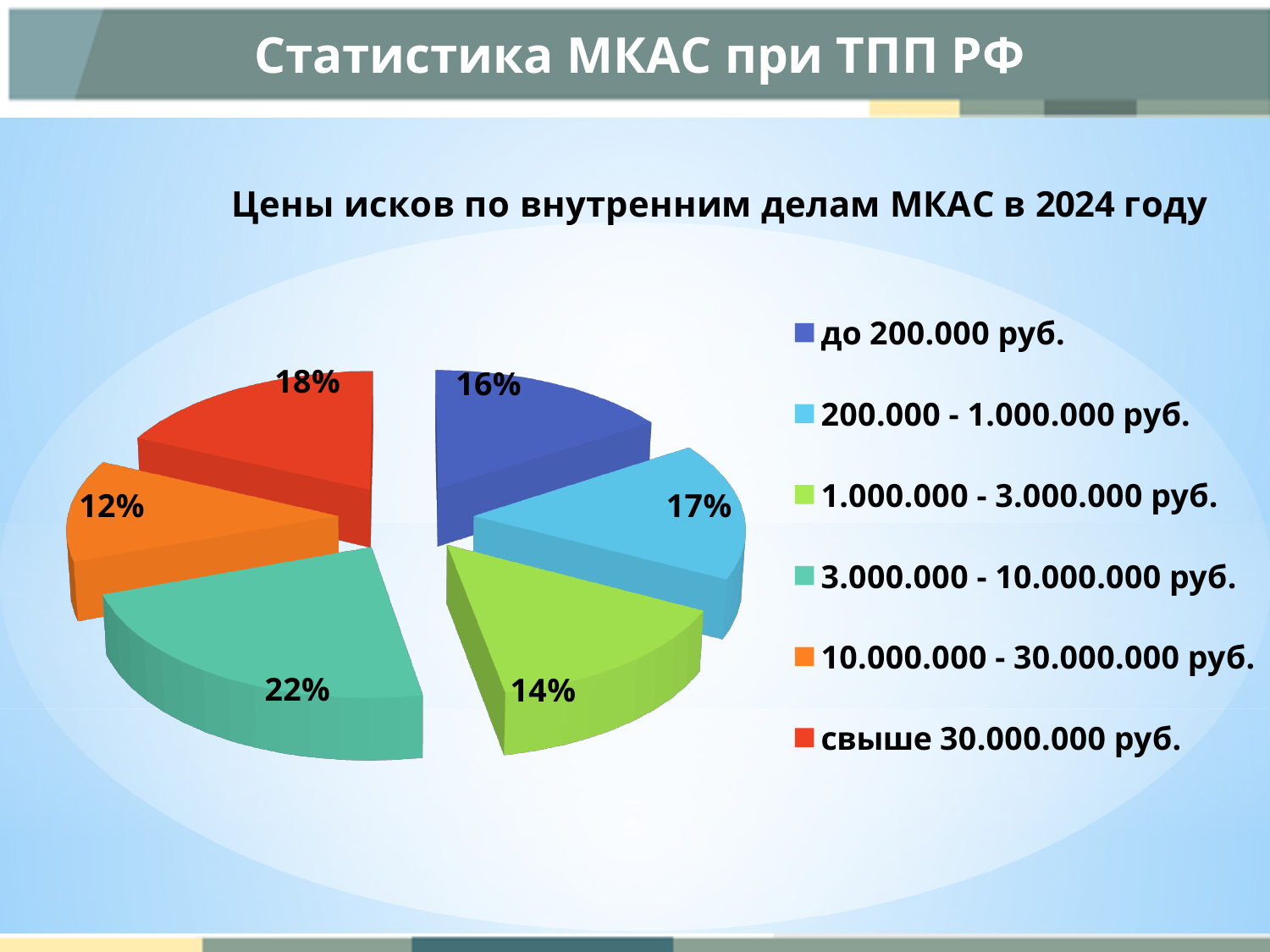
What type of chart is shown on the slide? Pie chart What is the difference in percentage points between the shares for '3.000.000 - 10.000.000 руб.' and '10.000.000 - 30.000.000 руб.'? 10% Which category has the largest share of the pie? 3.000.000 - 10.000.000 руб. What is the title of the chart? Цены исков по внутренним делам МКАС в 2024 году What share of the pie is the slice for 'свыше 30.000.000 руб.'? 18% How many categories does the pie chart have? 6 What share of the pie is the slice for '200.000 - 1.000.000 руб.'? 17% Which category has the smallest share of the pie? 10.000.000 - 30.000.000 руб. What share of the pie is the slice for '1.000.000 - 3.000.000 руб.'? 14%